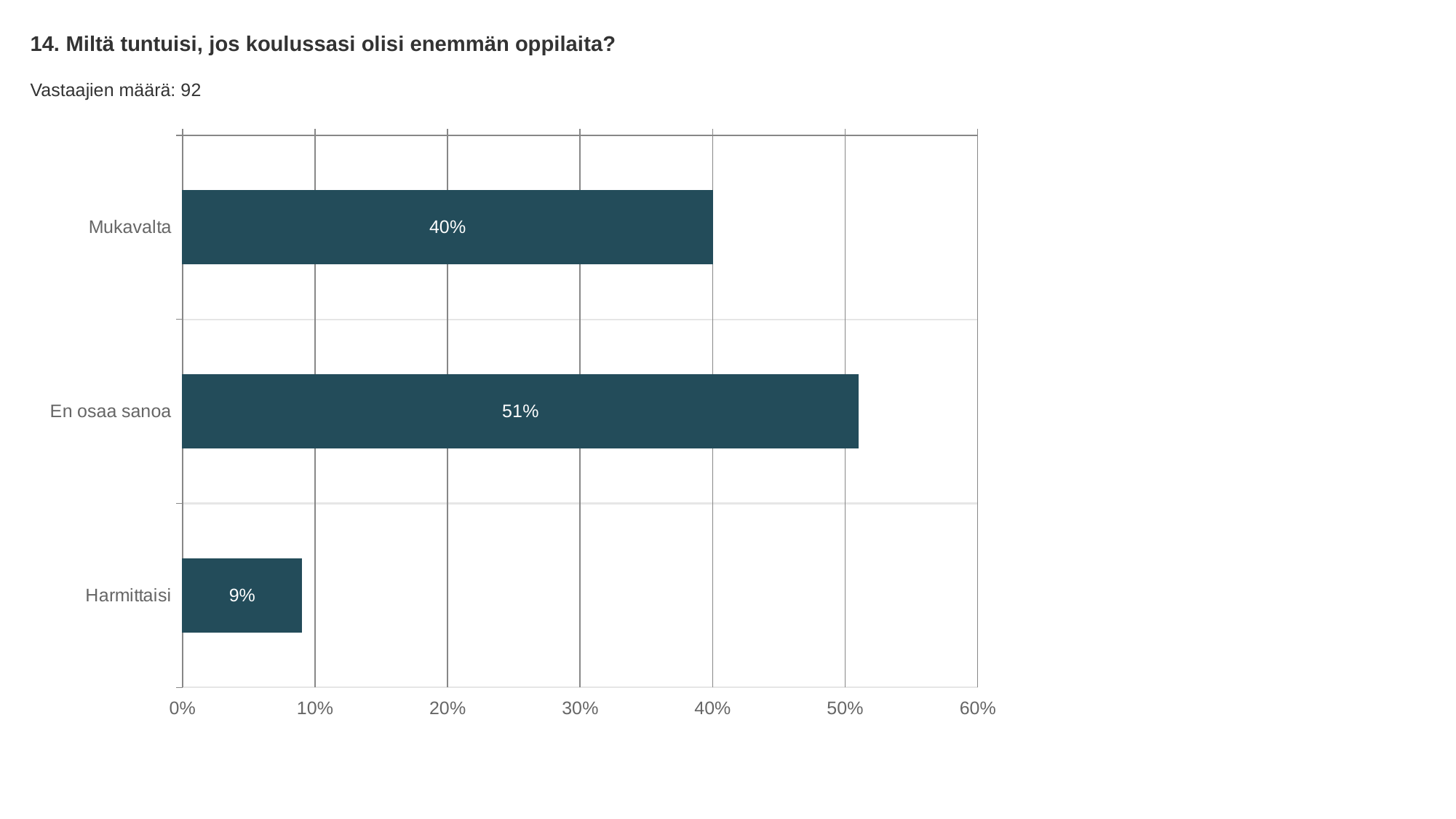
What is the value for Harmittaisi? 9% What kind of chart is shown on the slide? bar chart How many categories are shown in the chart? 3 What is the value for Mukavalta? 40% Is the value for En osaa sanoa greater or less than 50%? greater Which category has the highest value? En osaa sanoa What is the difference between the values for En osaa sanoa and Mukavalta? 11% How many respondents (Vastaajien määrä) are reported on the slide? 92 Which category has the lowest value? Harmittaisi Which is larger, the value for Mukavalta or the value for Harmittaisi? Mukavalta What is the difference between the values for Mukavalta and Harmittaisi? 31% What is the value for En osaa sanoa? 51%